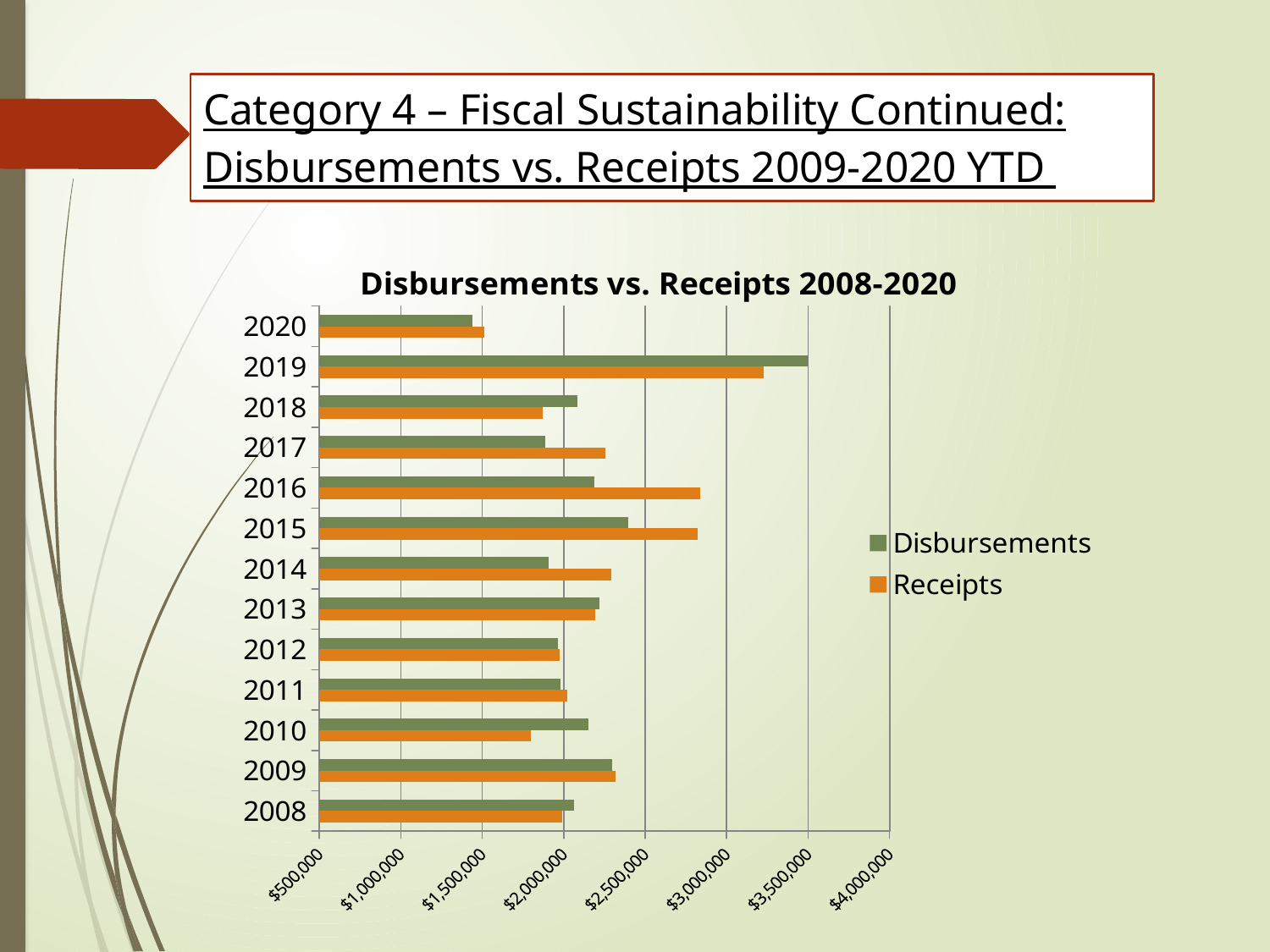
In 2016, which is larger, Disbursements or Receipts? Receipts Is the Receipts value for 2010 greater or less than $2,000,000? less Which year has the highest Receipts value? 2019 What is the title of the chart? Disbursements vs. Receipts 2008-2020 Is the Disbursements value for 2019 greater or less than $3,000,000? greater Which year has the highest Disbursements value? 2019 Which year has the lowest Disbursements value? 2020 In 2010, which is larger, Disbursements or Receipts? Disbursements How many series does the legend list in the Disbursements vs. Receipts chart? 2 Which year has the lowest Receipts value? 2020 How many years are shown on the y axis of the chart? 13 What kind of chart is shown on the slide? Bar chart